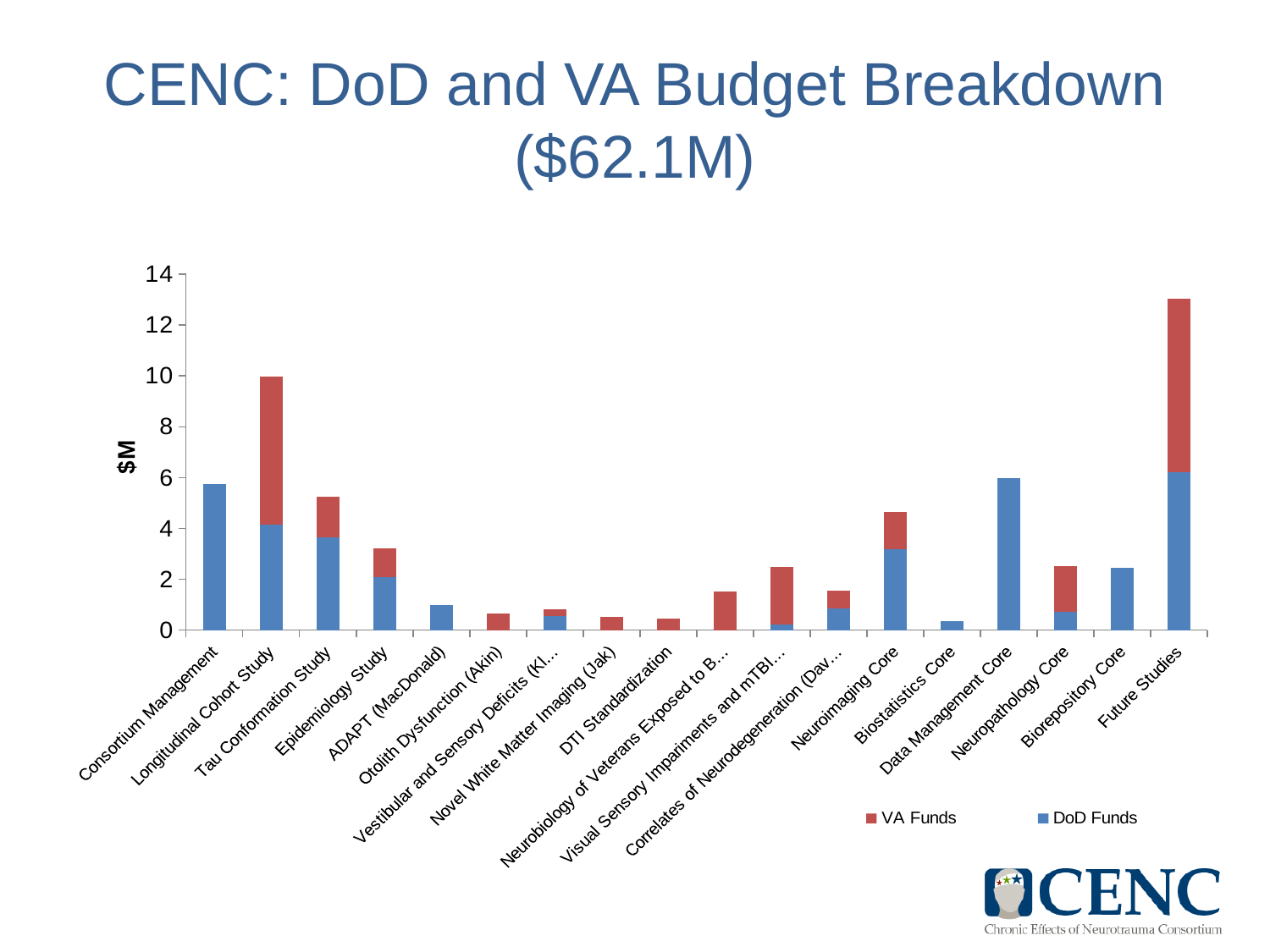
What kind of chart is shown on the slide? Stacked bar chart Which colour represents VA Funds in the chart? Red How many series does the legend list? 2 Which has the larger total bar, Future Studies or Longitudinal Cohort Study? Future Studies What is the title of the chart on the slide? CENC: DoD and VA Budget Breakdown ($62.1M) Is the total value for Future Studies greater or less than 12? greater Is the total value for Neuroimaging Core greater or less than 4? greater Which category has the highest total bar? Future Studies Is the total value for Longitudinal Cohort Study greater or less than 8? greater How many categories are shown along the x axis? 18 Which has the larger total bar, Tau Conformation Study or Epidemiology Study? Tau Conformation Study